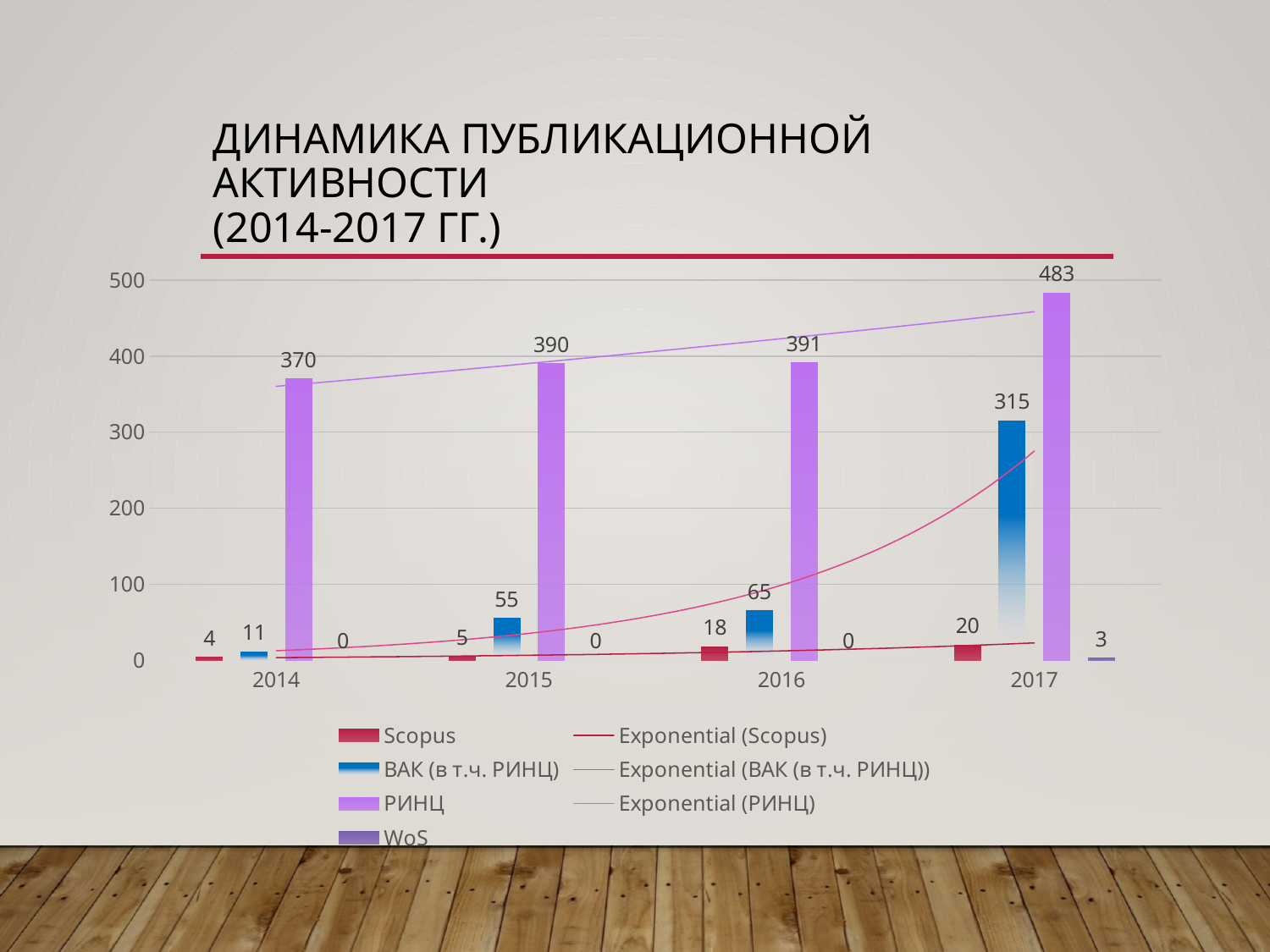
How many years are shown on the x axis? 4 What is the value for ВАК (в т.ч. РИНЦ) in 2015? 55 In which year is the РИНЦ value highest? 2017 Which is larger, the ВАК (в т.ч. РИНЦ) value in 2016 or in 2017? 2017 Do the ВАК (в т.ч. РИНЦ) values rise or fall from 2014 to 2017? rise What is the value for Scopus in 2016? 18 What is the value for WoS in 2017? 3 What is the difference between the РИНЦ values for 2017 and 2016? 92 What kind of chart is shown on the slide? bar chart How many entries does the legend list? 7 In which year is the Scopus value lowest? 2014 What is the value for РИНЦ in 2017? 483